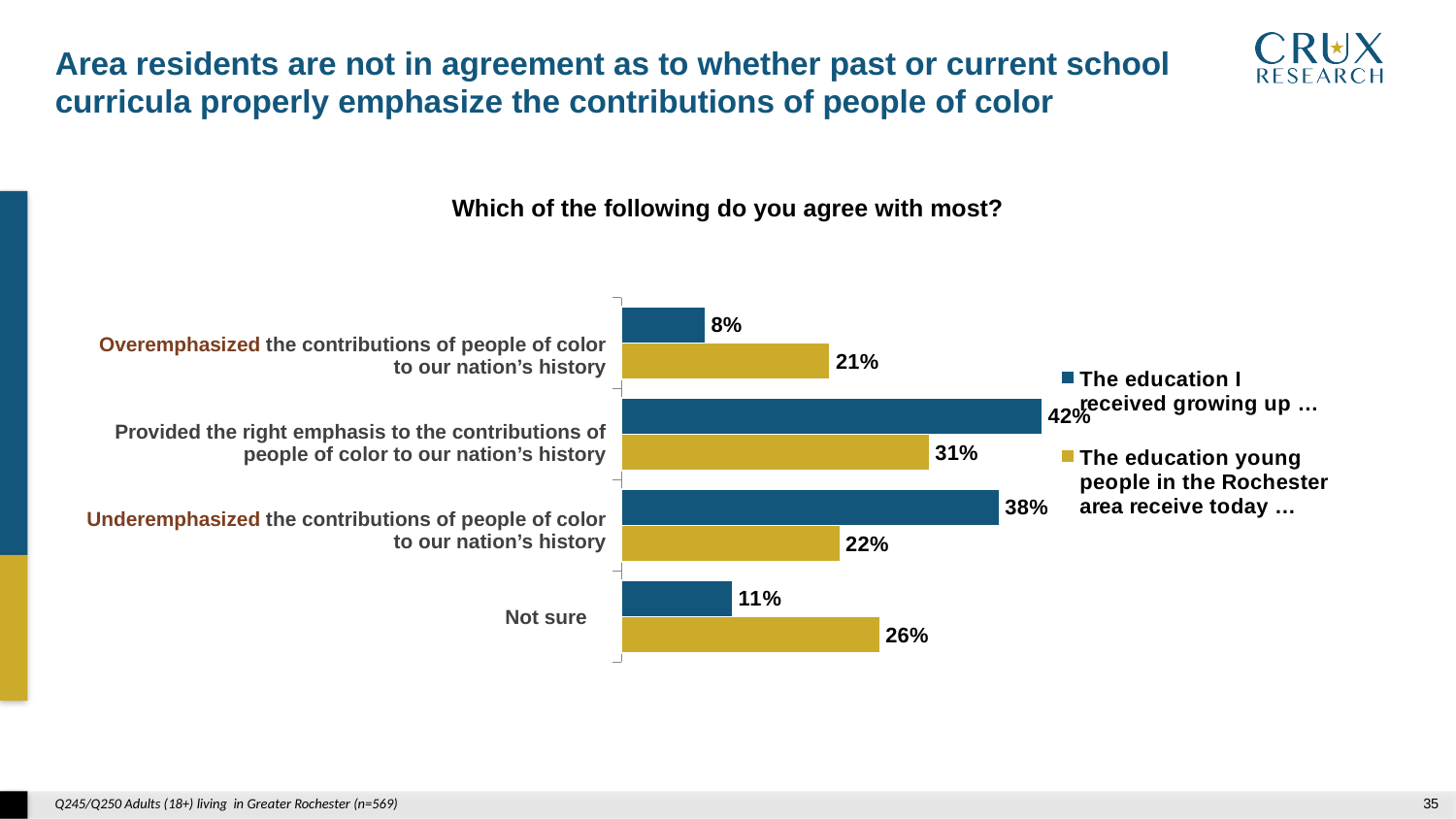
For the 'Not sure' category, which series has the larger value? The education young people in the Rochester area receive today How many response categories are shown on the chart? 4 What is the difference between the two series for the 'Underemphasized' category? 16% What percentage were 'Not sure' about the education young people in the Rochester area receive today? 26% Which category has the highest value for 'The education I received growing up'? Provided the right emphasis to the contributions of people of color to our nation's history What type of chart is shown on the slide? Bar chart What percentage said the education young people in the Rochester area receive today provides the right emphasis to the contributions of people of color? 31% What percentage of respondents said the education they received growing up overemphasized the contributions of people of color? 8% What percentage said the education they received growing up underemphasized the contributions of people of color? 38% Which category has the lowest value for 'The education young people in the Rochester area receive today'? Overemphasized the contributions of people of color to our nation's history How many series does the legend list? 2 What question is the chart titled with? Which of the following do you agree with most?